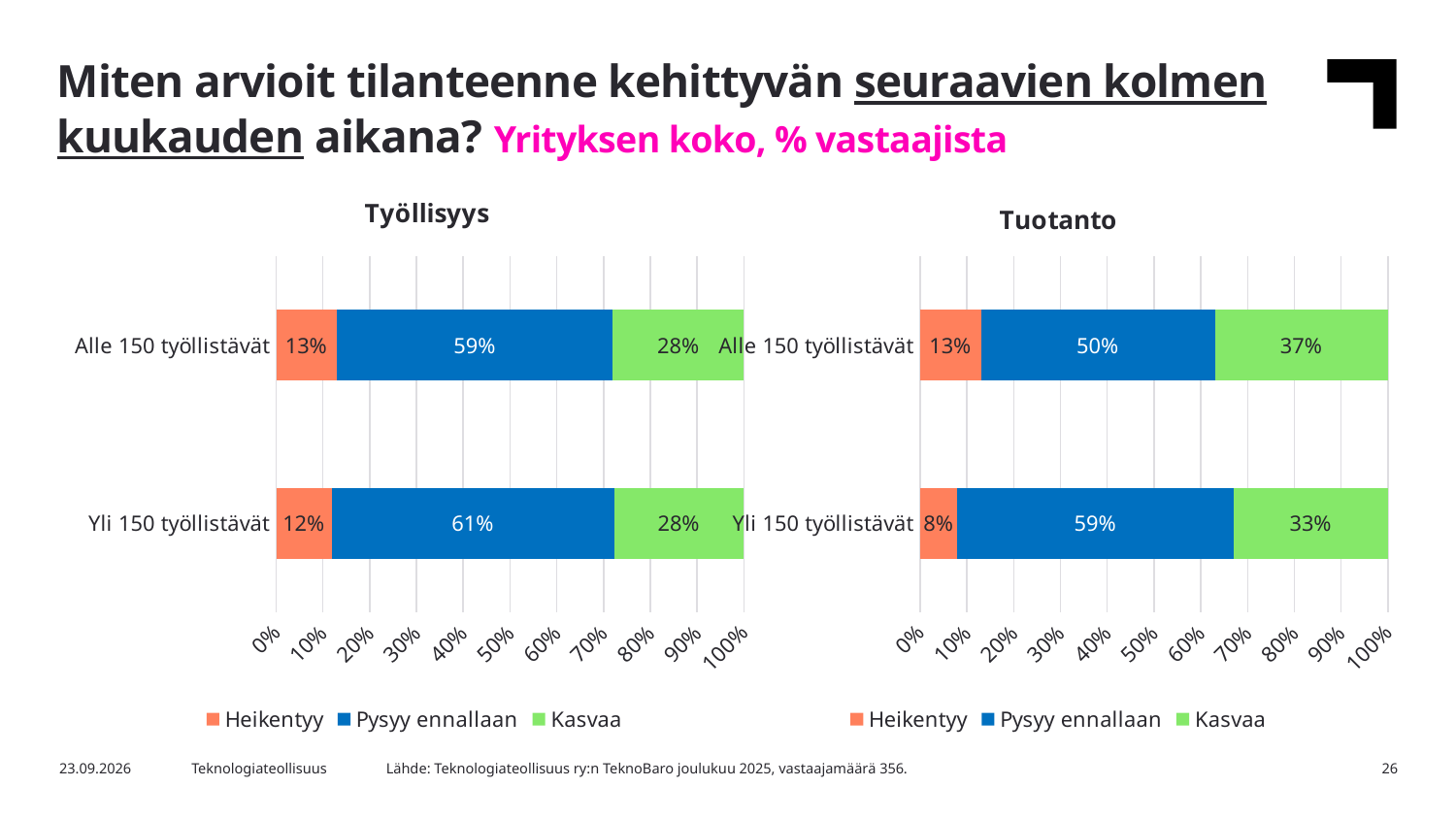
How many categories are shown in the Työllisyys chart? 2 In the Tuotanto chart, what is the difference between the Kasvaa values for Alle 150 työllistävät and Yli 150 työllistävät? 4% What kind of chart is the Työllisyys chart? Stacked bar chart In the Työllisyys chart, which category has the higher Pysyy ennallaan value, Alle 150 työllistävät or Yli 150 työllistävät? Yli 150 työllistävät In the Tuotanto chart, what is the Pysyy ennallaan value for Yli 150 työllistävät? 59% In the Tuotanto chart, which category has the lower Heikentyy value? Yli 150 työllistävät How many series does the legend of the Tuotanto chart list? 3 In the Tuotanto chart, what is the total of the stacked bar for Alle 150 työllistävät? 100% In the Työllisyys chart, what is the Pysyy ennallaan value for Alle 150 työllistävät? 59% In the Työllisyys chart, what is the Heikentyy value for Yli 150 työllistävät? 12% In the Tuotanto chart, what is the Kasvaa value for Alle 150 työllistävät? 37% In the Tuotanto chart, what is the Heikentyy value for Yli 150 työllistävät? 8%